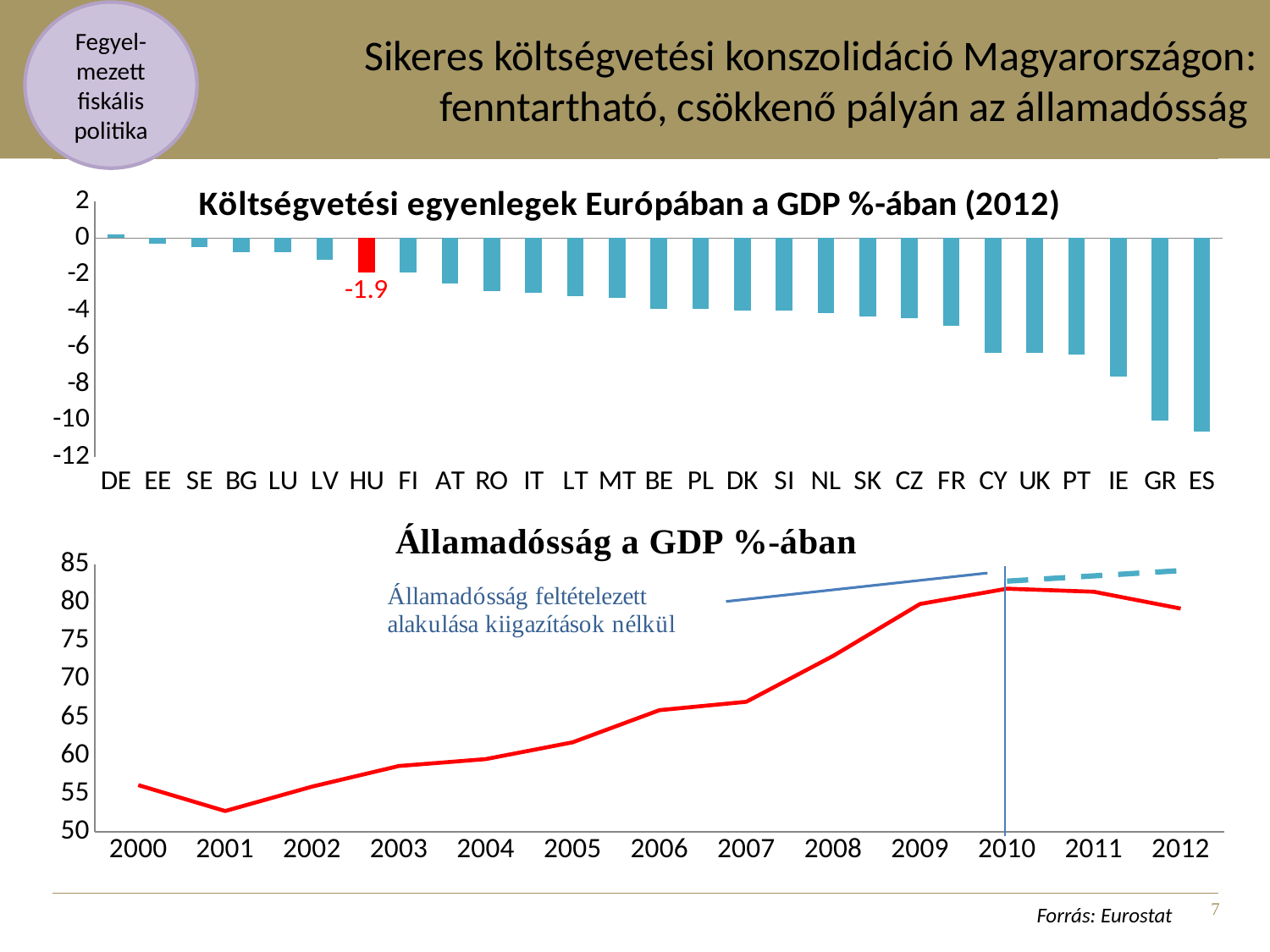
In the bottom chart 'Államadósság a GDP %-ában', which year has the lowest value? 2001 What kind of chart is the bottom chart, 'Államadósság a GDP %-ában'? line chart What kind of chart is the top chart, 'Költségvetési egyenlegek Európában a GDP %-ában (2012)'? bar chart How many years are shown on the x axis of the bottom chart 'Államadósság a GDP %-ában'? 13 In the top chart 'Költségvetési egyenlegek Európában a GDP %-ában (2012)', which has the larger value, GR or IE? IE How many countries are shown in the top chart 'Költségvetési egyenlegek Európában a GDP %-ában (2012)'? 27 In the bottom chart 'Államadósság a GDP %-ában', does the red line rise or fall between 2001 and 2010? rise In the bottom chart 'Államadósság a GDP %-ában', is the value for 2009 greater or less than 75? greater In the top chart 'Költségvetési egyenlegek Európában a GDP %-ában (2012)', which country has the highest value? DE In the top chart 'Költségvetési egyenlegek Európában a GDP %-ában (2012)', what is the value for HU? -1.9 In the top chart 'Költségvetési egyenlegek Európában a GDP %-ában (2012)', which country has the lowest value? ES In the top chart 'Költségvetési egyenlegek Európában a GDP %-ában (2012)', is the value for IE greater or less than -6? less